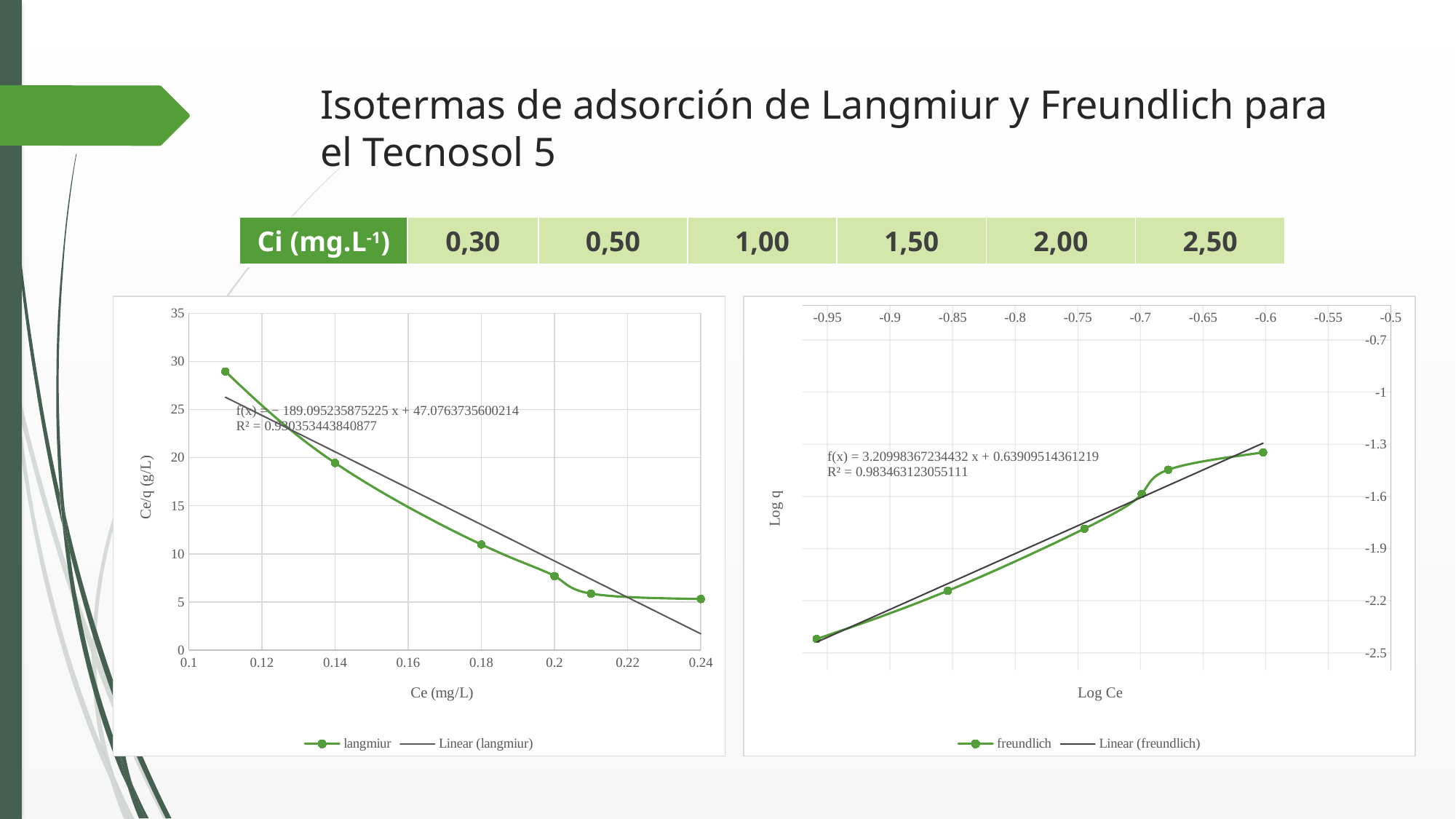
How many data points are plotted on the right chart (freundlich series)? 6 On the left chart, is the langmiur value at Ce = 0.14 greater or less than 15? greater How many entries does the legend of the left chart list? 2 On the left chart, is the langmiur value at Ce = 0.24 greater or less than 10? less What kind of chart is the left chart on the slide? line chart How many data points are plotted on the left chart (langmiur series)? 6 On the right chart, is the freundlich value at Log Ce = -0.95 greater or less than -2.2? less On the left chart, do the langmiur values rise or fall as Ce (mg/L) increases? fall What is the x-axis title of the left chart? Ce (mg/L) On the right chart, do the freundlich values rise or fall as Log Ce increases? rise What R² value is shown on the right chart? 0.983463123055111